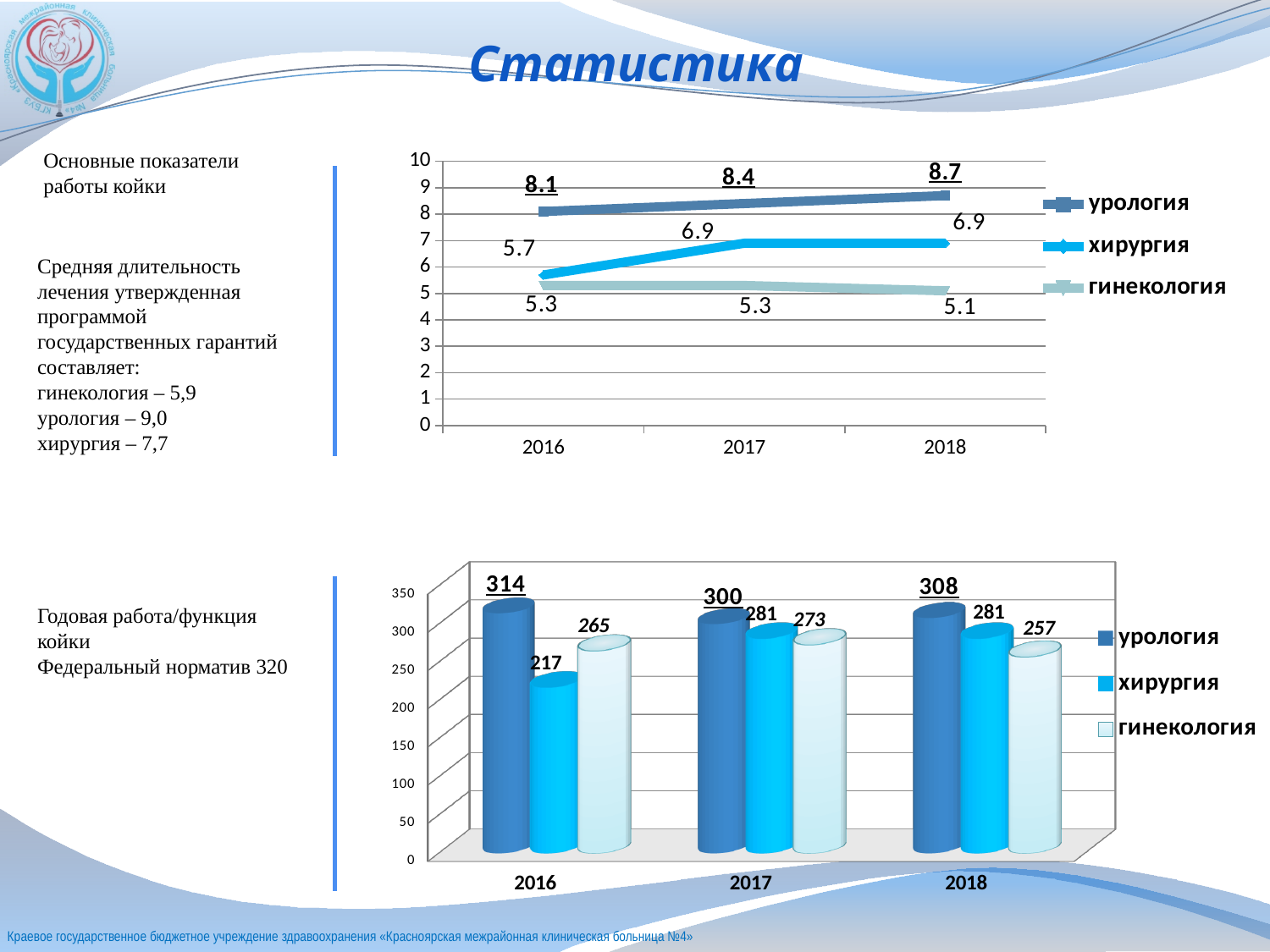
In the top chart, what is the value for хирургия in 2016? 5.7 In the bottom chart, what is the value for гинекология in 2017? 273 In the top chart, what is the difference between урология and хирургия in 2017? 1.5 In the top chart, how many series does the legend list? 3 What kind of chart is the bottom chart? bar chart What kind of chart is the top chart? line chart In the bottom chart, which year has the highest value for урология? 2016 In the bottom chart, which is larger in 2018: хирургия or гинекология? хирургия In the top chart, does the урология line rise or fall from 2016 to 2018? rise In the bottom chart, what is the value for хирургия in 2016? 217 In the top chart, what is the value for гинекология in 2018? 5.1 In the top chart, what is the value for урология in 2018? 8.7